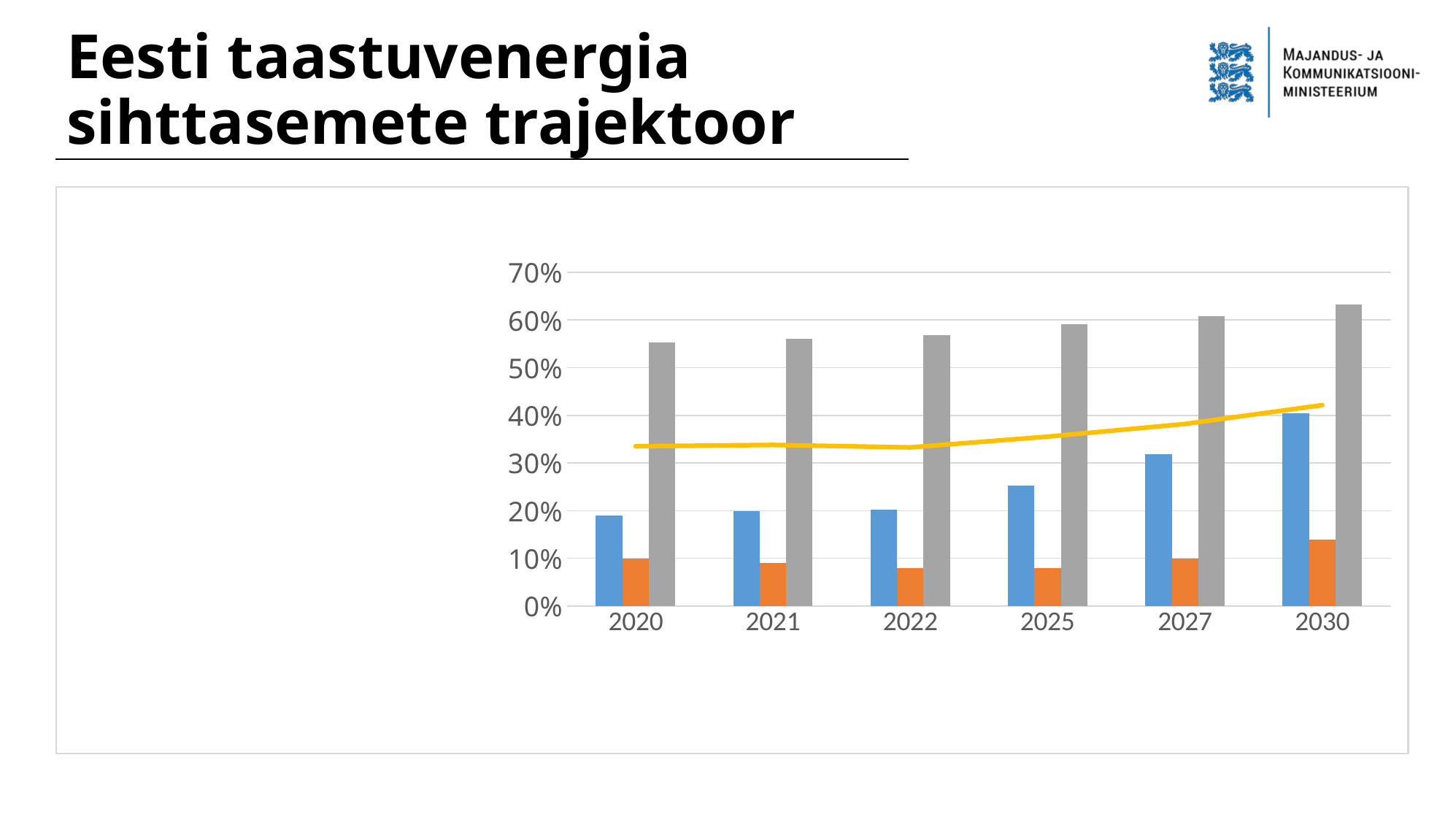
Is the blue bar for 2020 greater or less than 30%? less Which is larger in 2030, the blue bar or the orange bar? The blue bar Is the orange bar for 2030 greater or less than 10%? greater Is the blue bar for 2025 greater or less than 20%? greater Which year has the tallest blue bar? 2030 Which year has the tallest grey bar? 2030 Do the grey bars rise or fall from 2020 to 2030? Rise What kind of chart is shown on the slide? Bar chart with a line What is the highest value shown on the vertical axis? 70% How many categories are shown on the x axis of the chart? 6